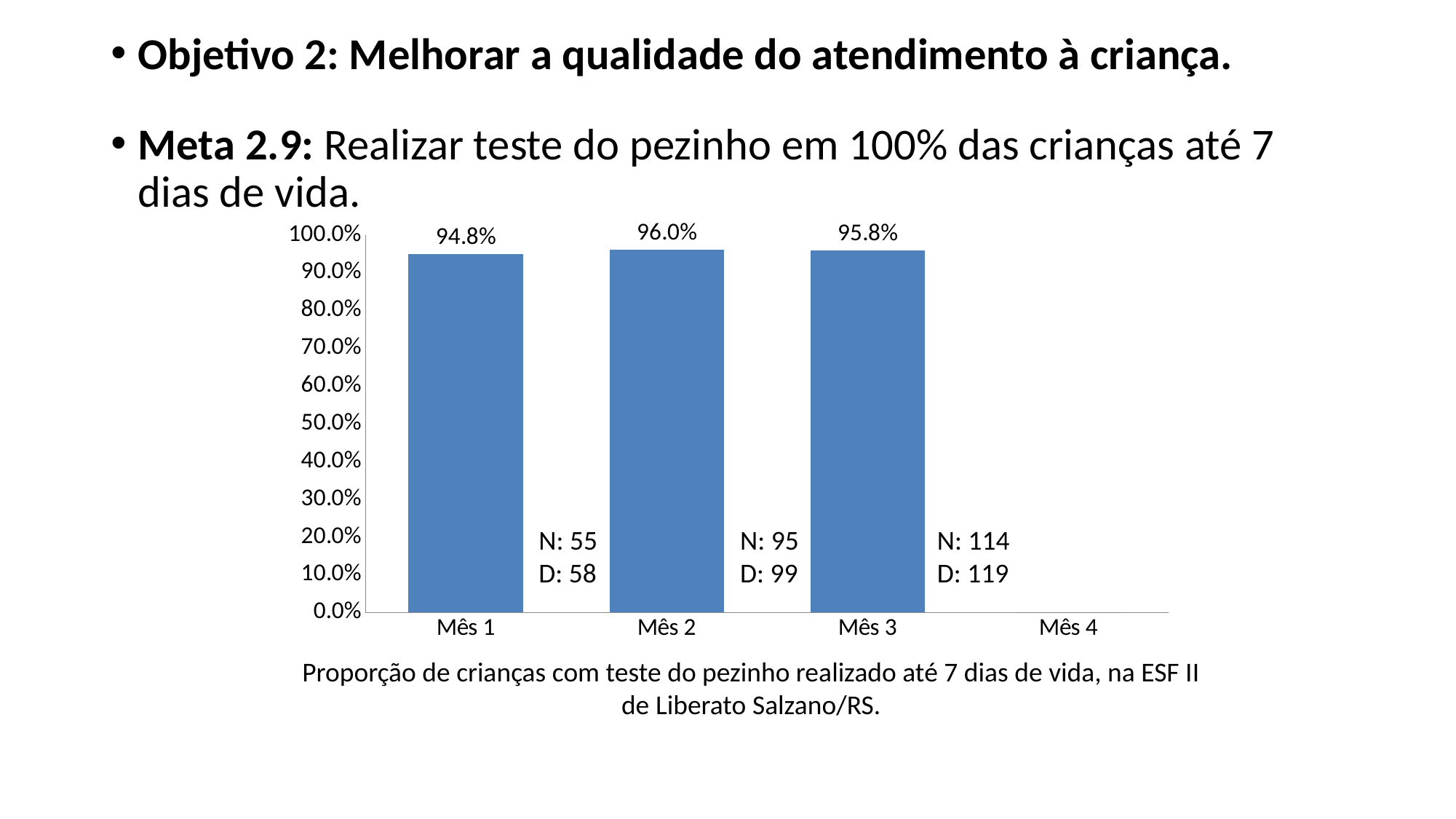
Does the value rise or fall from Mês 1 to Mês 2? Rise Is the value for Mês 1 greater or less than 90.0%? greater Among the months with a plotted bar, which has the lowest value? Mês 1 What is the value for Mês 3? 95.8% Which is larger, the value for Mês 3 or the value for Mês 1? Mês 3 What is the difference between the values for Mês 2 and Mês 1? 1.2 percentage points Which month has the highest value? Mês 2 How many bars are plotted in the chart? 3 What is the value for Mês 1? 94.8% What is the N value annotated for Mês 3? 114 What is the value for Mês 2? 96.0% What kind of chart is shown? Bar chart